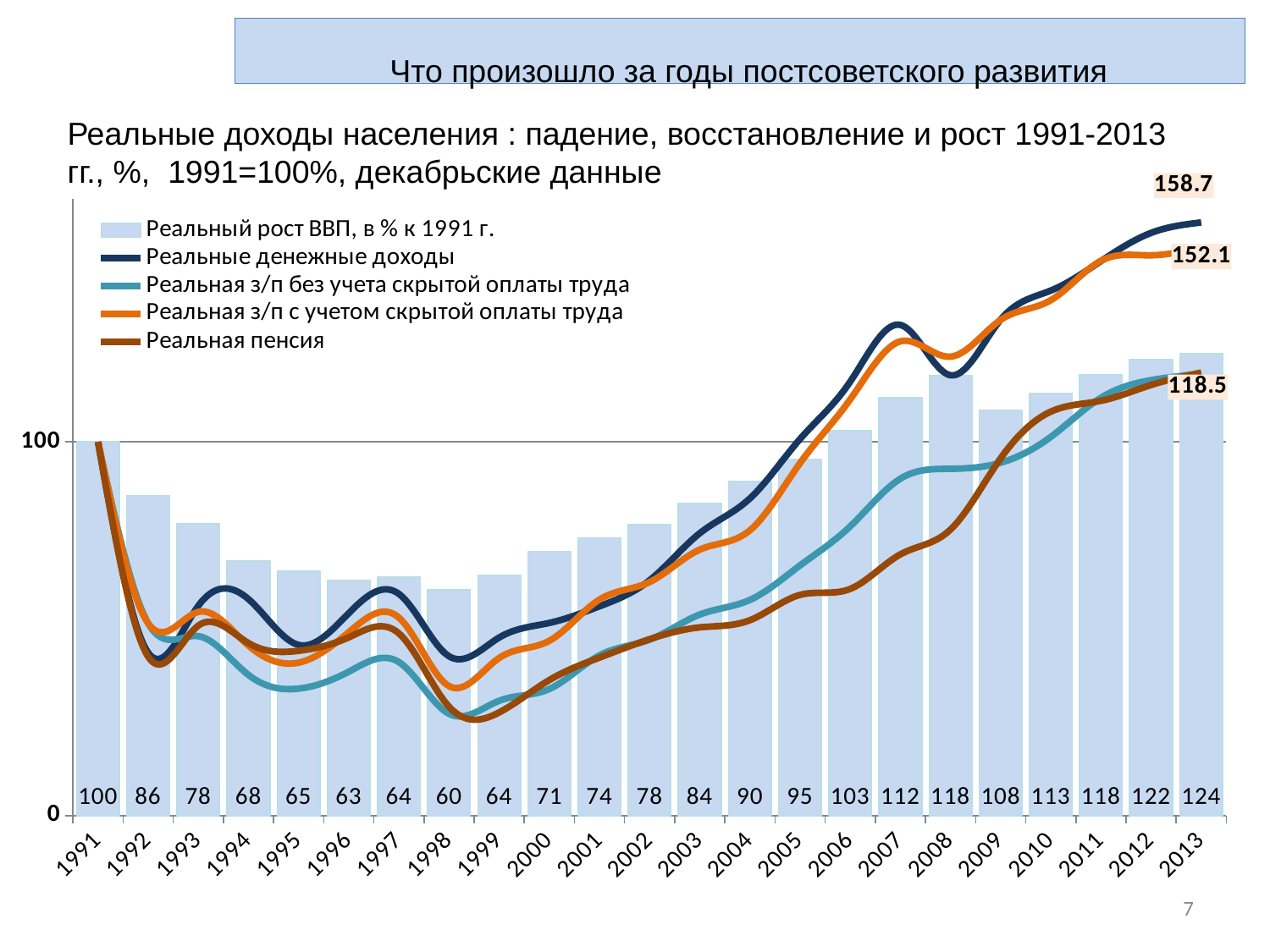
What is the value of the real GDP growth bar for 2013? 124 Do the real GDP growth bars rise or fall from 1991 to 1998? fall How many years are shown on the x axis? 23 In which year is the real GDP growth bar highest? 2013 In which year is the real GDP growth bar lowest? 1998 What is the value of the real GDP growth bar for 1998? 60 Which year has the larger real GDP growth value, 2005 or 2011? 2011 What is the difference between the real GDP growth values for 2013 and 1991? 24 What is the final labelled value of the real money incomes (Реальные денежные доходы) line? 158.7 By how much does the real GDP growth value fall from 2008 to 2009? 10 What is the labelled value of the real pension (Реальная пенсия) line at the end of the series? 118.5 How many series does the legend list? 5